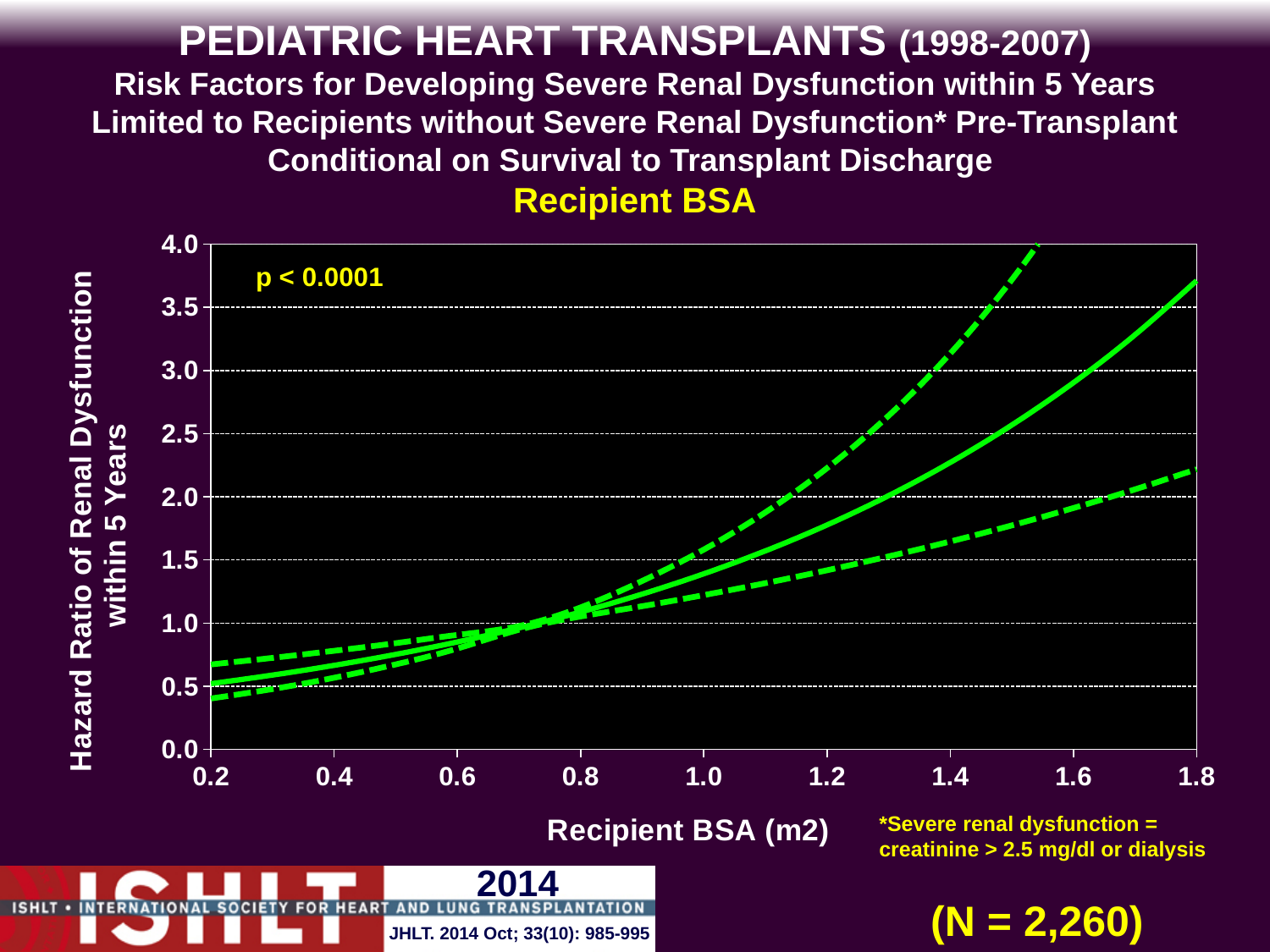
Is the hazard ratio on the solid line at a Recipient BSA of 1.8 greater or less than 3.0? greater What p-value is printed on the chart? p < 0.0001 At which Recipient BSA value shown on the x axis is the hazard ratio on the solid line highest? 1.8 Is the hazard ratio on the solid line at a Recipient BSA of 0.2 greater or less than 1.0? less Which has the larger hazard ratio on the solid line: a Recipient BSA of 0.4 or 1.6? 1.6 What is the label of the x axis? Recipient BSA (m2) Is the hazard ratio on the lower dashed line at a Recipient BSA of 1.8 greater or less than 2.0? greater What kind of chart is shown on the slide? line chart How many lines are plotted on the chart? 3 How does the hazard ratio change as Recipient BSA increases from 0.2 to 1.8? it rises